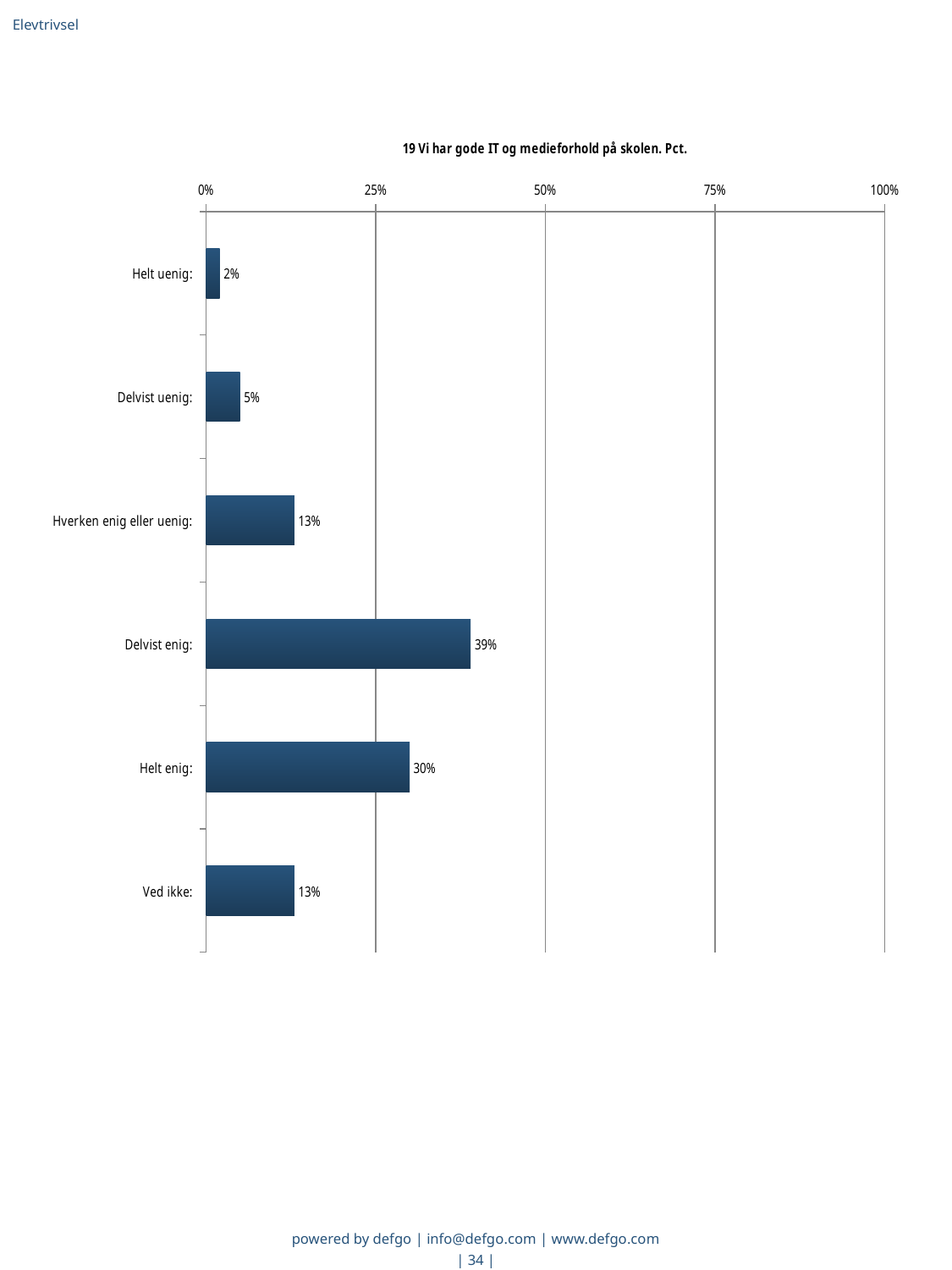
What is the difference between the values for "Delvist enig" and "Helt enig"? 9% Which is larger, the value for "Delvist uenig" or the value for "Hverken enig eller uenig"? Hverken enig eller uenig Which category has the highest value? Delvist enig Is the value for "Helt enig" greater or less than 25%? greater What is the value for "Helt uenig"? 2% What is the value for "Ved ikke"? 13% Which category has the lowest value? Helt uenig What is the highest value shown on the percentage axis? 100% What kind of chart is shown on the slide? bar chart How many categories are shown in the chart? 6 What is the title of the chart? 19 Vi har gode IT og medieforhold på skolen. Pct. What is the value for "Delvist enig"? 39%